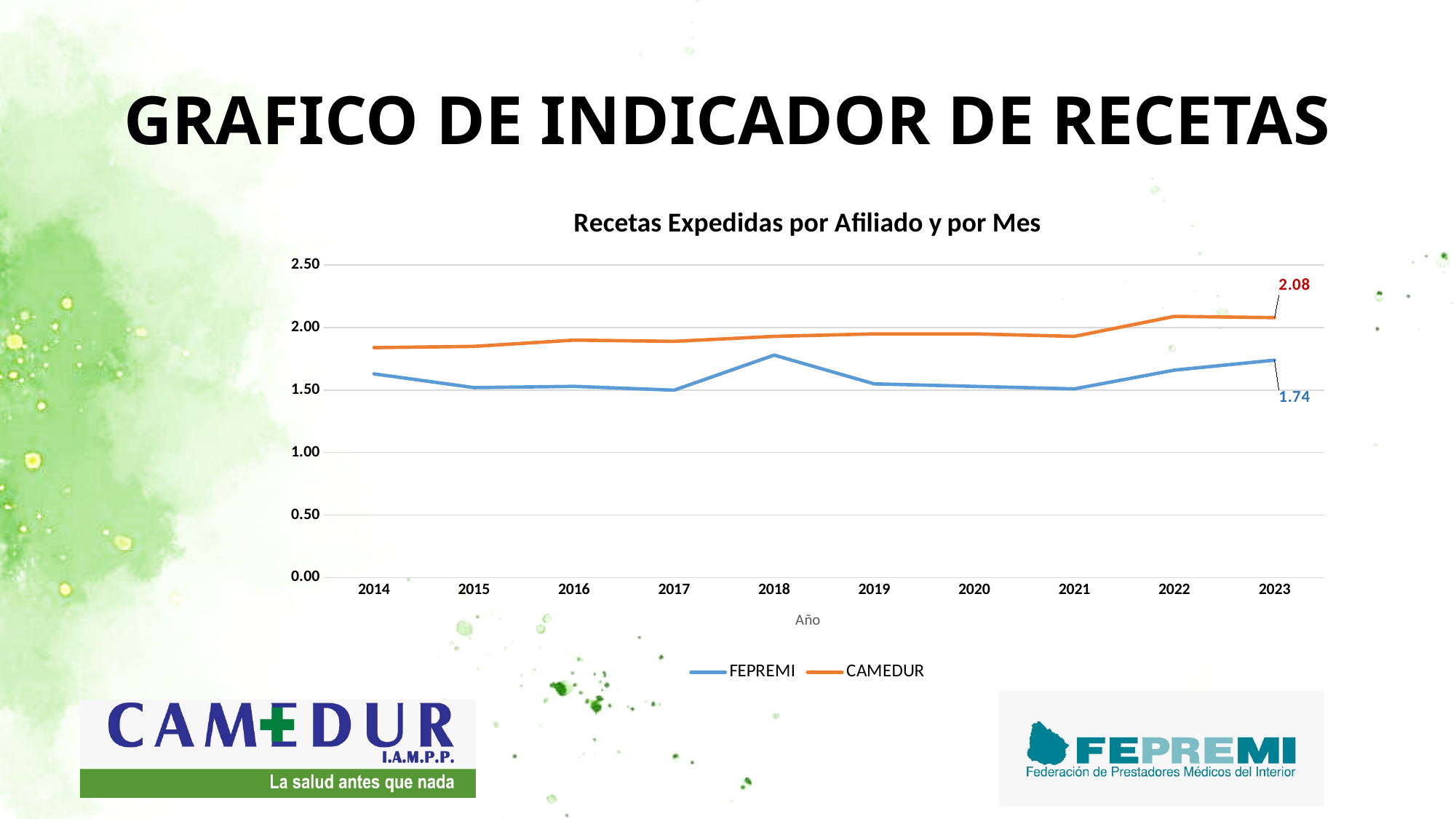
Is the value for FEPREMI in 2017 greater or less than 2.00? less Is the value for FEPREMI in 2018 greater or less than 1.50? greater How many years are shown on the x axis of the chart? 10 How many series does the legend list? 2 What is the difference between the CAMEDUR and FEPREMI values in 2023? 0.34 What is the value for FEPREMI in 2023? 1.74 What is the value for CAMEDUR in 2023? 2.08 What is the title of the chart? Recetas Expedidas por Afiliado y por Mes Is the value for CAMEDUR in 2014 greater or less than 1.50? greater Does the CAMEDUR line generally rise or fall from 2014 to 2023? rise What kind of chart is shown on the slide? line chart In 2023, which series has the higher value, FEPREMI or CAMEDUR? CAMEDUR